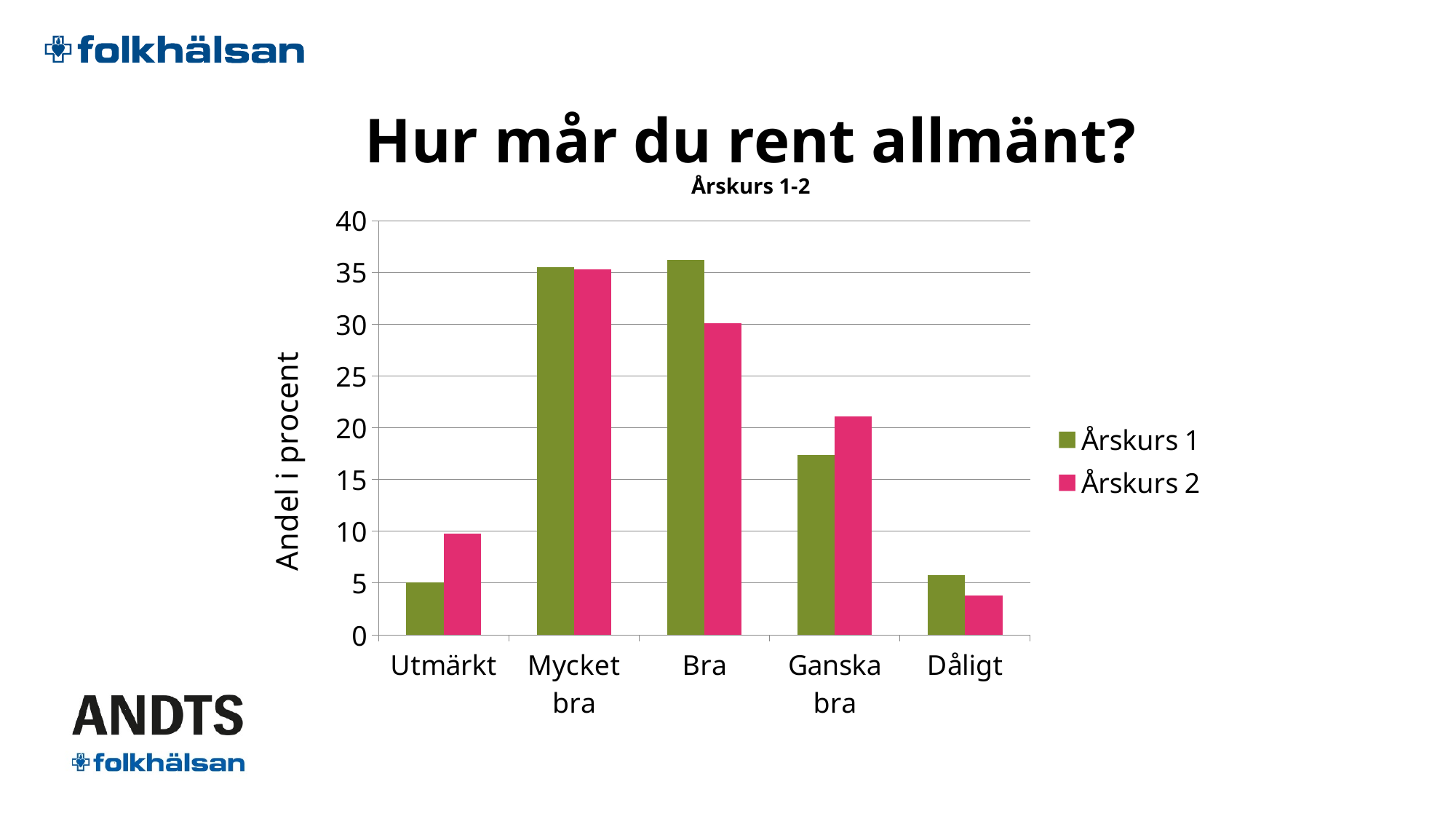
For the category Ganska bra, which series has the larger value, Årskurs 1 or Årskurs 2? Årskurs 2 How many series does the chart's legend list? 2 Which category has the lowest value for Årskurs 2? Dåligt Is the value for Ganska bra in the Årskurs 2 series greater or less than 20? greater What is the label on the vertical axis of the chart? Andel i procent For the category Bra, which series has the larger value, Årskurs 1 or Årskurs 2? Årskurs 1 Is the value for Bra in the Årskurs 1 series greater or less than 35? greater Which category has the highest value for Årskurs 2? Mycket bra What kind of chart is shown on the slide? bar chart Is the value for Dåligt in the Årskurs 2 series greater or less than 5? less How many categories are shown on the x axis of the chart? 5 For the category Utmärkt, which series has the larger value, Årskurs 1 or Årskurs 2? Årskurs 2